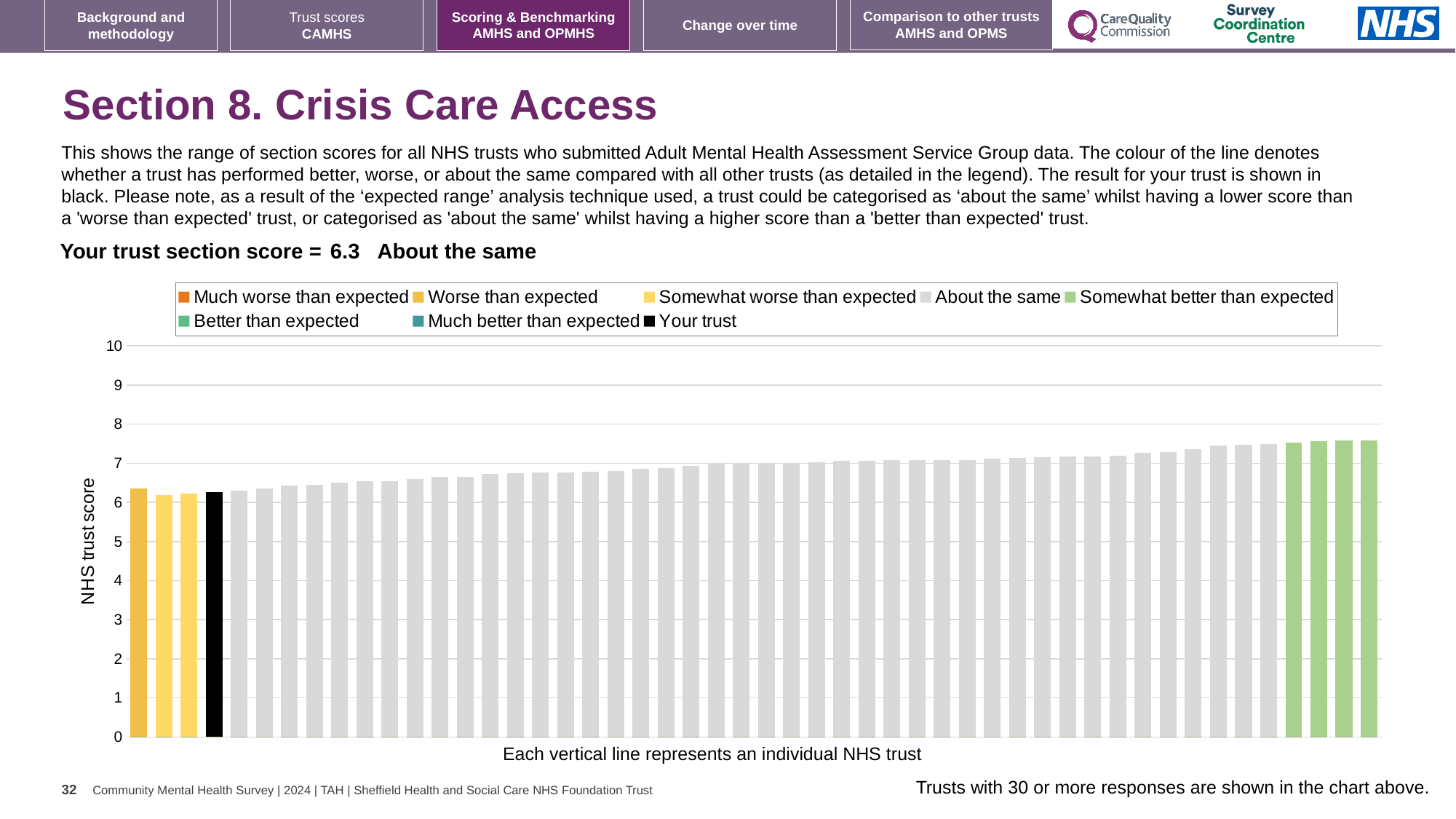
Which legend category do the tallest bars on the right of the chart belong to? Somewhat better than expected How many bars are shaded green in the chart? 4 What kind of chart is shown on the slide? bar chart Is the value for your trust greater or less than 5? greater What is the section score for your trust shown on the slide? 6.3 What is the label on the vertical axis of the chart? NHS trust score Is the shortest bar in the chart greater or less than 6? greater Do the bar values rise or fall moving from left to right along the x axis? rise Which performance category is your trust placed in for this section? About the same What colour is the bar representing your trust? black How many entries does the chart legend list? 8 Is the tallest bar in the chart greater or less than 8? less